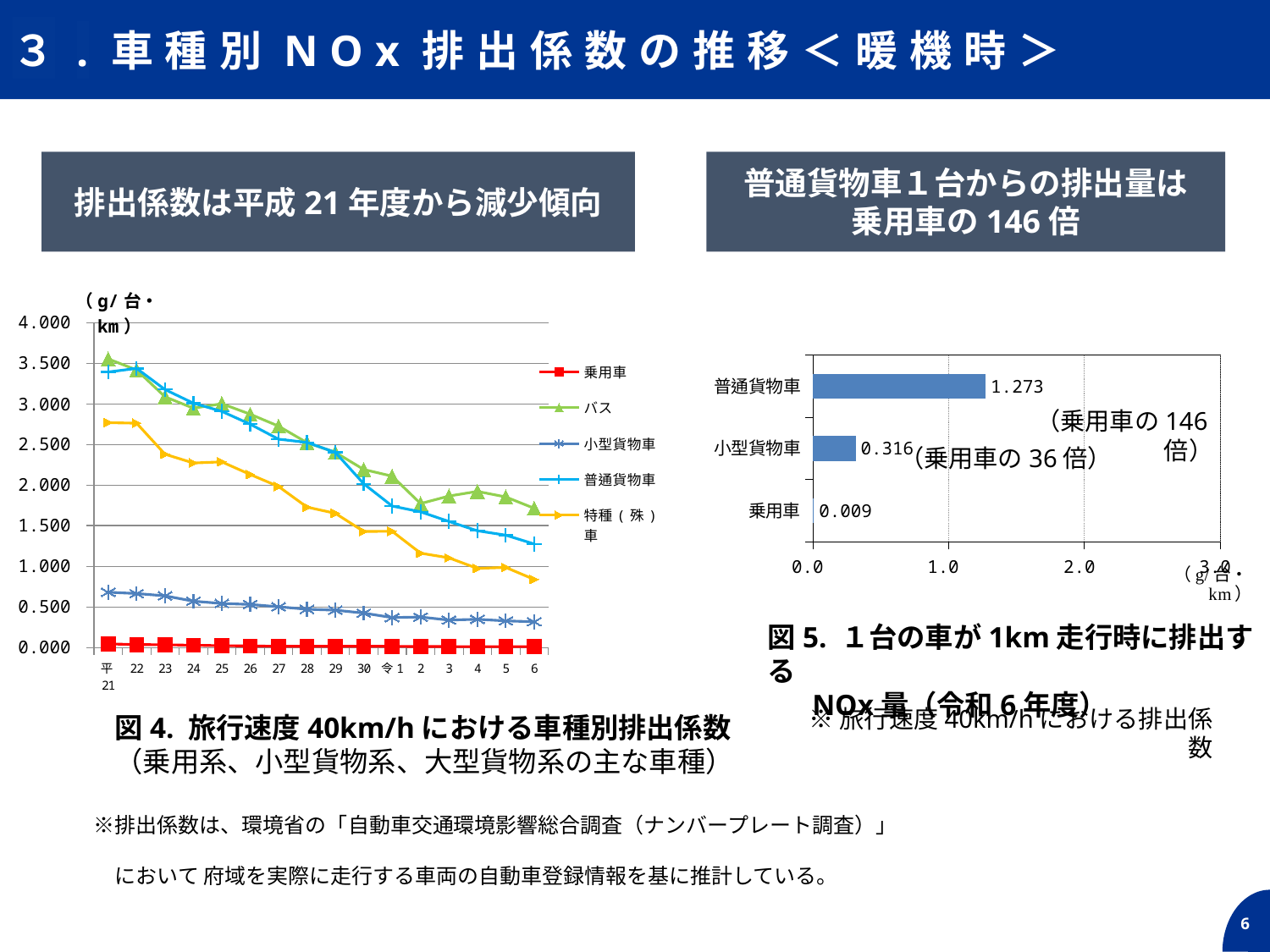
In the bar chart on the right (図5), what is the value for 普通貨物車? 1.273 In the bar chart on the right (図5), what is the value for 小型貨物車? 0.316 In the line chart on the left (図4), is the value for バス at 平21 greater or less than 3.000? greater In the line chart on the left (図4), does the value for 普通貨物車 rise or fall from 平21 to 令6? fall In the line chart on the left (図4), how many series does the legend list? 5 What kind of chart is the chart on the right (図5)? bar chart In the bar chart on the right (図5), which category has the highest value? 普通貨物車 In the bar chart on the right (図5), how many categories are shown? 3 In the bar chart on the right (図5), what is the difference between the values for 普通貨物車 and 小型貨物車? 0.957 In the line chart on the left (図4), which series has the lowest values across the whole period? 乗用車 In the bar chart on the right (図5), what is the value for 乗用車? 0.009 In the bar chart on the right (図5), which category has the lowest value? 乗用車